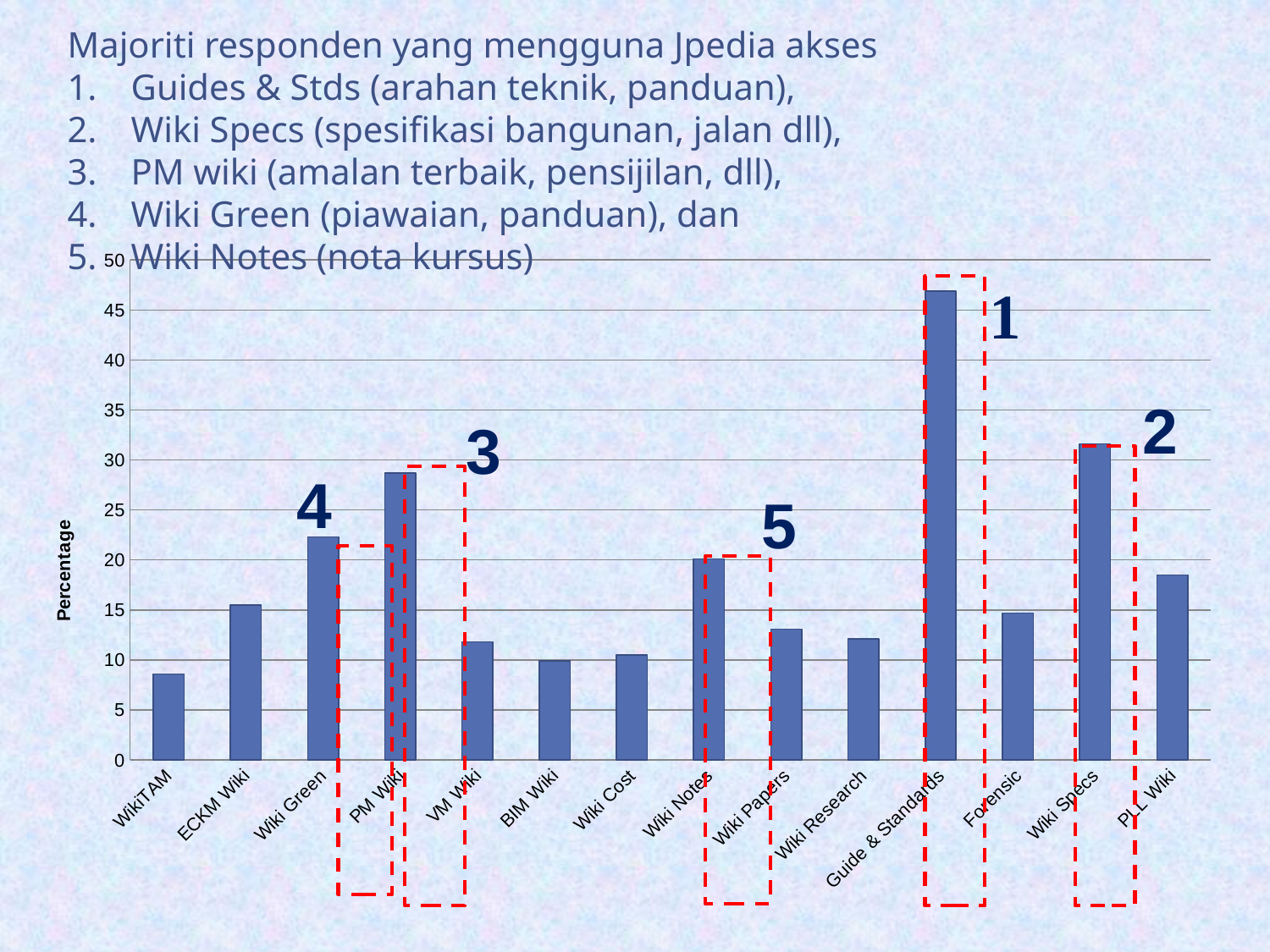
How many categories are plotted on the x axis of the chart? 14 Is the value for PM Wiki greater or less than 30? less What kind of chart is shown on the slide? bar chart Which is larger, the value for Wiki Green or the value for Wiki Notes? Wiki Green Is the value for Guide & Standards greater or less than 45? greater Which category has the lowest bar in the chart? WikiTAM Which category has the highest bar in the chart? Guide & Standards Is the value for WikiTAM greater or less than 10? less Which is larger, the value for Wiki Specs or the value for PM Wiki? Wiki Specs What is the label on the vertical axis of the chart? Percentage